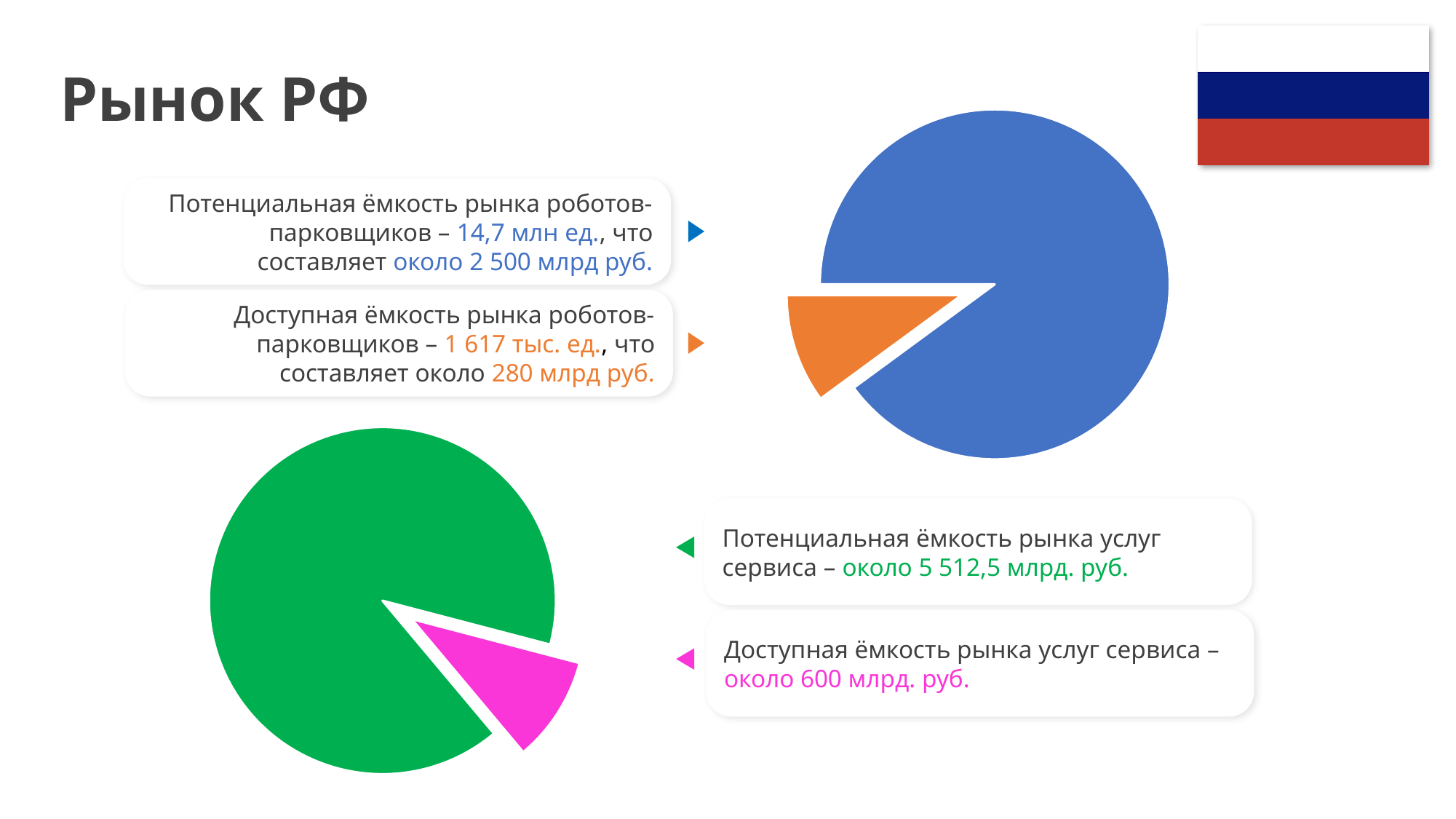
In the bottom-left pie chart, which slice is larger, the green one or the pink one? the green one In the top-right pie chart, which slice is larger, the blue one or the orange one? the blue one How many slices does the bottom-left pie chart have? 2 In the bottom-left pie chart, what colour is the slice representing the available service market capacity (доступная ёмкость рынка услуг сервиса)? pink In the top-right pie chart, what colour is the slice representing the available market capacity of parking robots (доступная ёмкость)? orange In the top-right pie chart, which slice is the smallest? the orange slice (доступная ёмкость рынка роботов-парковщиков) How many slices does the top-right pie chart have? 2 How many pie charts are shown on the slide? 2 What kind of chart is the chart in the bottom-left of the slide? pie chart In the bottom-left pie chart, which slice is the largest? the green slice (потенциальная ёмкость рынка услуг сервиса) What kind of chart is the chart in the top-right of the slide? pie chart